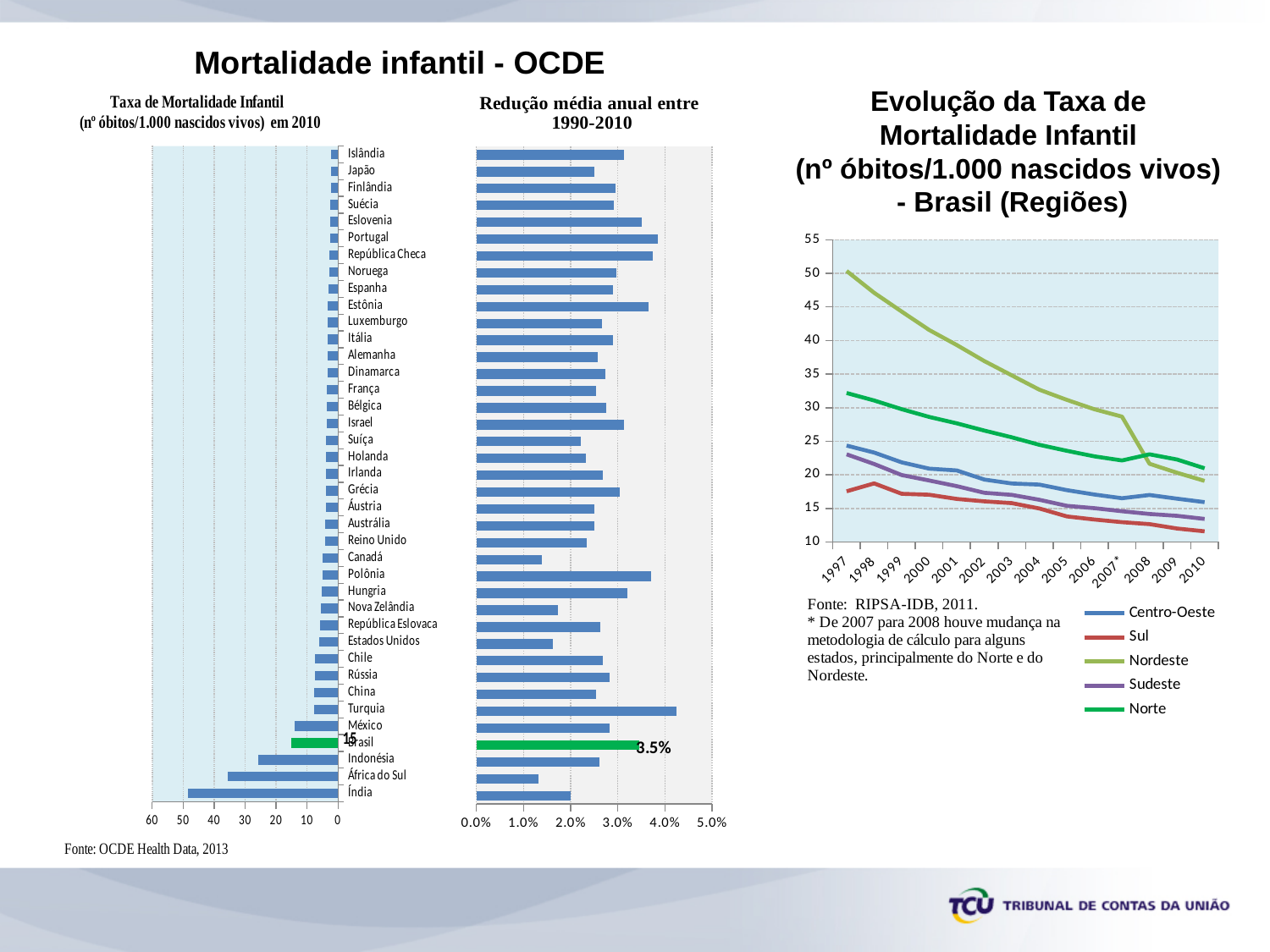
On the right chart (Evolução da Taxa de Mortalidade Infantil - Brasil (Regiões)), does the Nordeste line rise or fall from 1997 to 2010? fall On the right chart (Evolução da Taxa de Mortalidade Infantil - Brasil (Regiões)), which region has the highest value in 1997? Nordeste On the right chart (Evolução da Taxa de Mortalidade Infantil - Brasil (Regiões)), which region has the lowest value in 2010? Sul On the left chart (Taxa de Mortalidade Infantil em 2010), what is the value for Brasil? 15 On the left chart (Taxa de Mortalidade Infantil em 2010), which country has the highest infant mortality rate? Índia On the left chart (Taxa de Mortalidade Infantil em 2010), which has the higher value, Índia or México? Índia On the middle chart (Redução média anual entre 1990-2010), what is the value for Brasil? 3.5% How many series does the legend of the right chart (Evolução da Taxa de Mortalidade Infantil - Brasil (Regiões)) list? 5 On the middle chart (Redução média anual entre 1990-2010), which country has the highest average annual reduction? Turquia On the left chart (Taxa de Mortalidade Infantil em 2010), is the value for Índia greater or less than 40? greater What kind of chart is the right chart (Evolução da Taxa de Mortalidade Infantil - Brasil (Regiões))? line chart On the right chart (Evolução da Taxa de Mortalidade Infantil - Brasil (Regiões)), is the value for Nordeste in 1997 greater or less than 45? greater